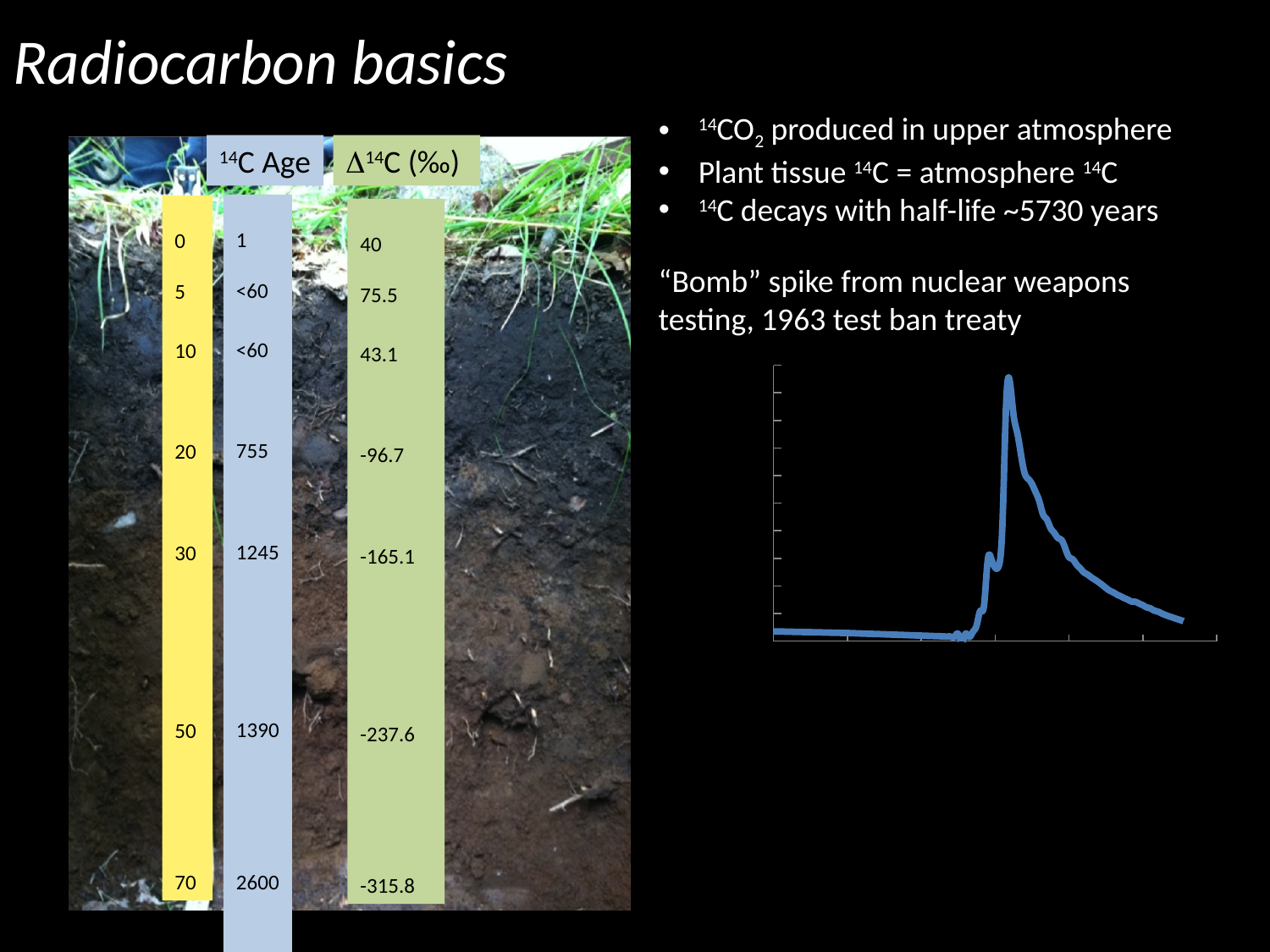
In the line chart on the right, do the values rise or fall sharply just before the peak? rise In the line chart on the right, after the line reaches its peak, do the values rise or fall toward the right end of the x axis? fall What kind of chart is shown on the right side of the slide? line chart Does the line chart on the right side of the slide have a legend? No How many lines are plotted in the chart on the right side of the slide? 1 What colour is the line in the chart on the right side of the slide? blue